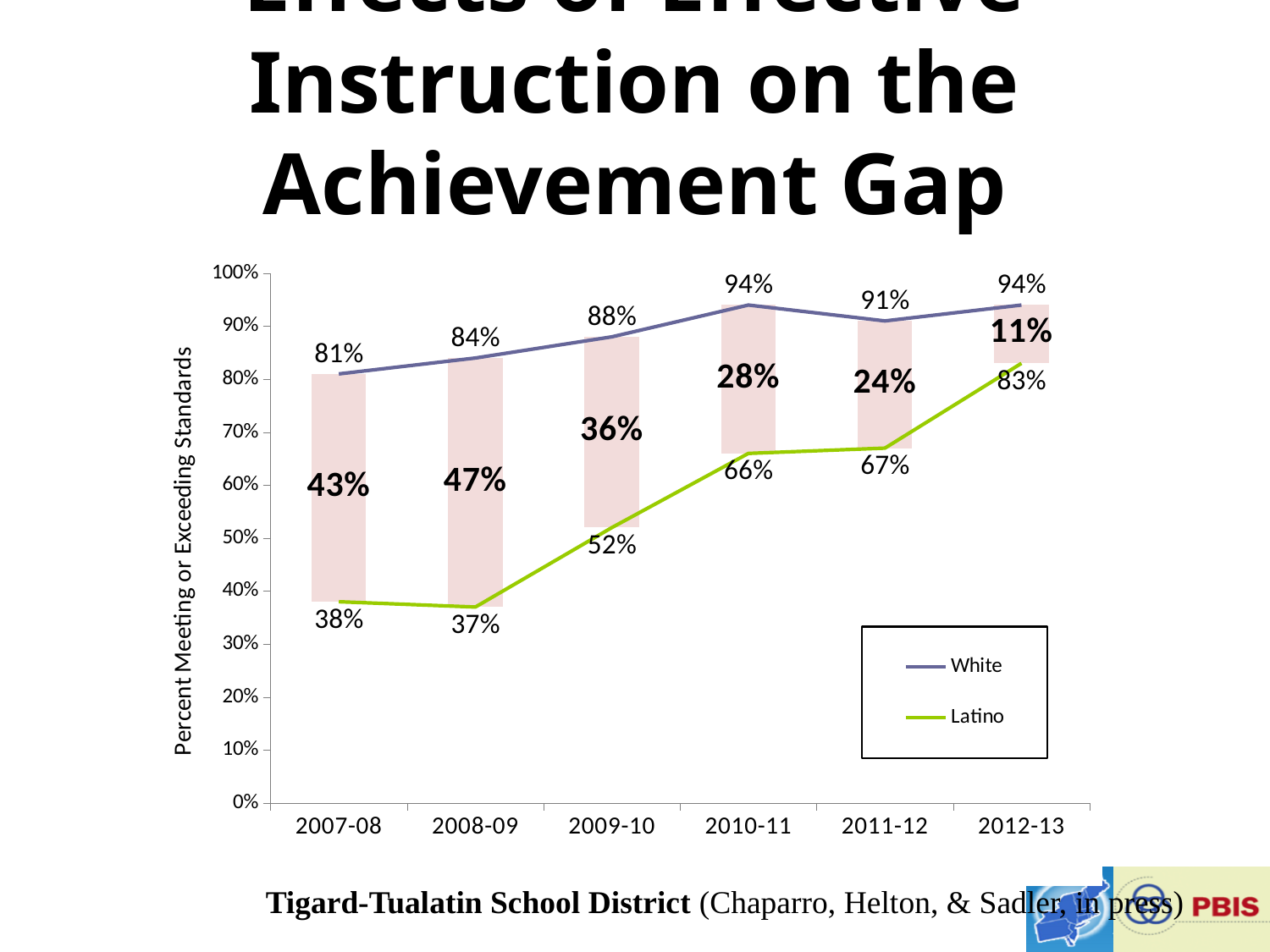
What is the difference between the Latino values in 2012-13 and 2007-08? 45% What is the value for Latino students in 2009-10? 52% What percentage of Latino students met or exceeded standards in 2012-13? 83% In which school year is the Latino value lowest? 2008-09 Does the Latino series generally rise or fall from 2008-09 to 2012-13? Rise What kind of chart is shown on the slide? Combination line and bar chart Which series has the higher value in 2010-11, White or Latino? White What is the difference between the White and Latino values in 2011-12? 24% What percentage of White students met or exceeded standards in 2007-08? 81% How many series does the legend list? 2 How many school years are shown on the x axis? 6 What is the highest value shown for the White series? 94%